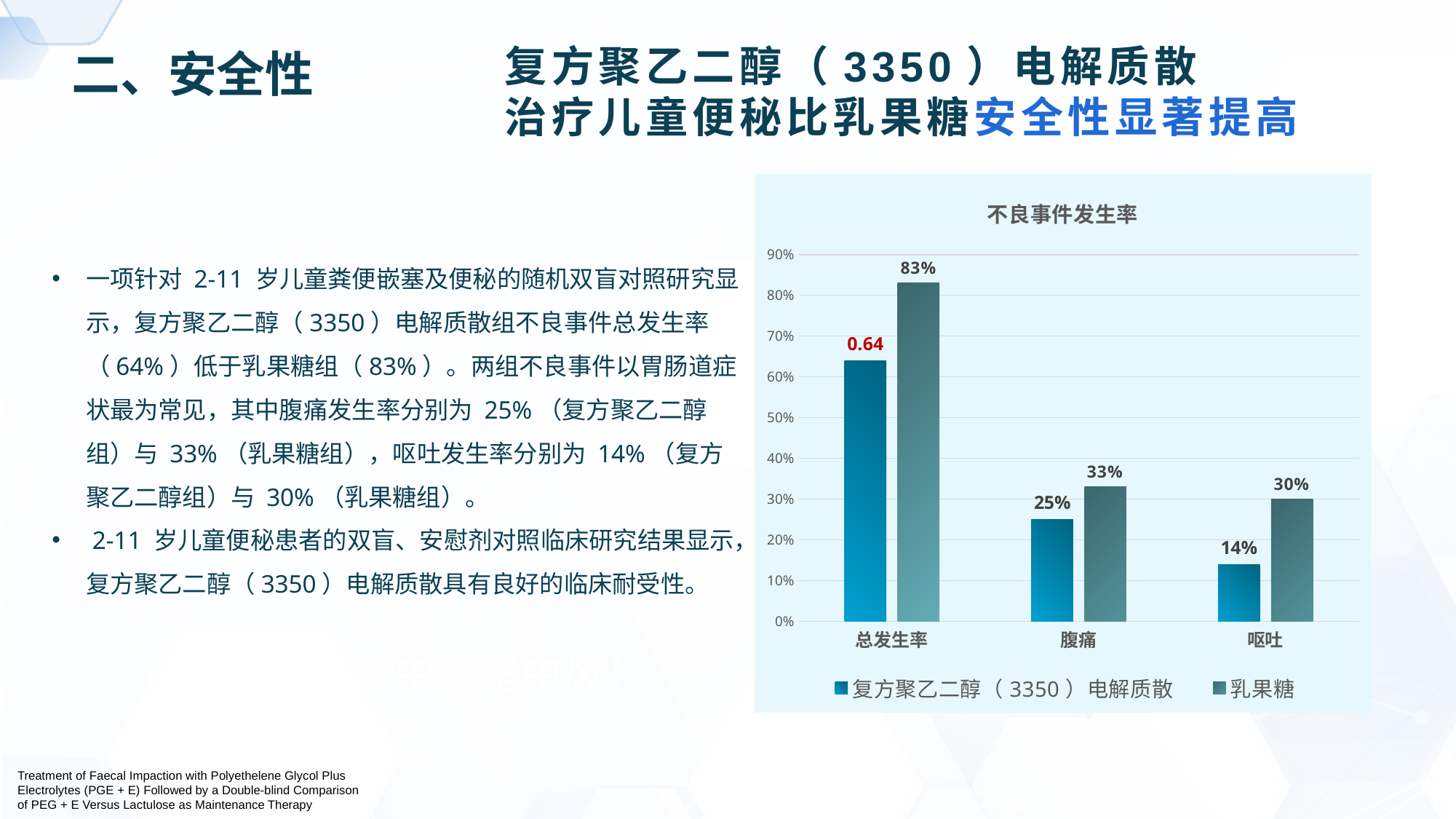
How many series does the chart legend list? 2 What is the value for 乳果糖 in the 总发生率 category? 83% What data label is printed on the 复方聚乙二醇（3350）电解质散 bar for 总发生率? 0.64 What is the difference between the 乳果糖 and 复方聚乙二醇（3350）电解质散 values in the 腹痛 category? 8% Which category has the lowest value for 复方聚乙二醇（3350）电解质散? 呕吐 Which category has the highest value for 乳果糖? 总发生率 How many categories are shown on the x axis of the chart? 3 What is the title of the chart? 不良事件发生率 What is the value for 复方聚乙二醇（3350）电解质散 in the 腹痛 category? 25% In the 呕吐 category, which series has the larger value, 复方聚乙二醇（3350）电解质散 or 乳果糖? 乳果糖 What type of chart is shown on the slide? bar chart What is the value for 乳果糖 in the 呕吐 category? 30%